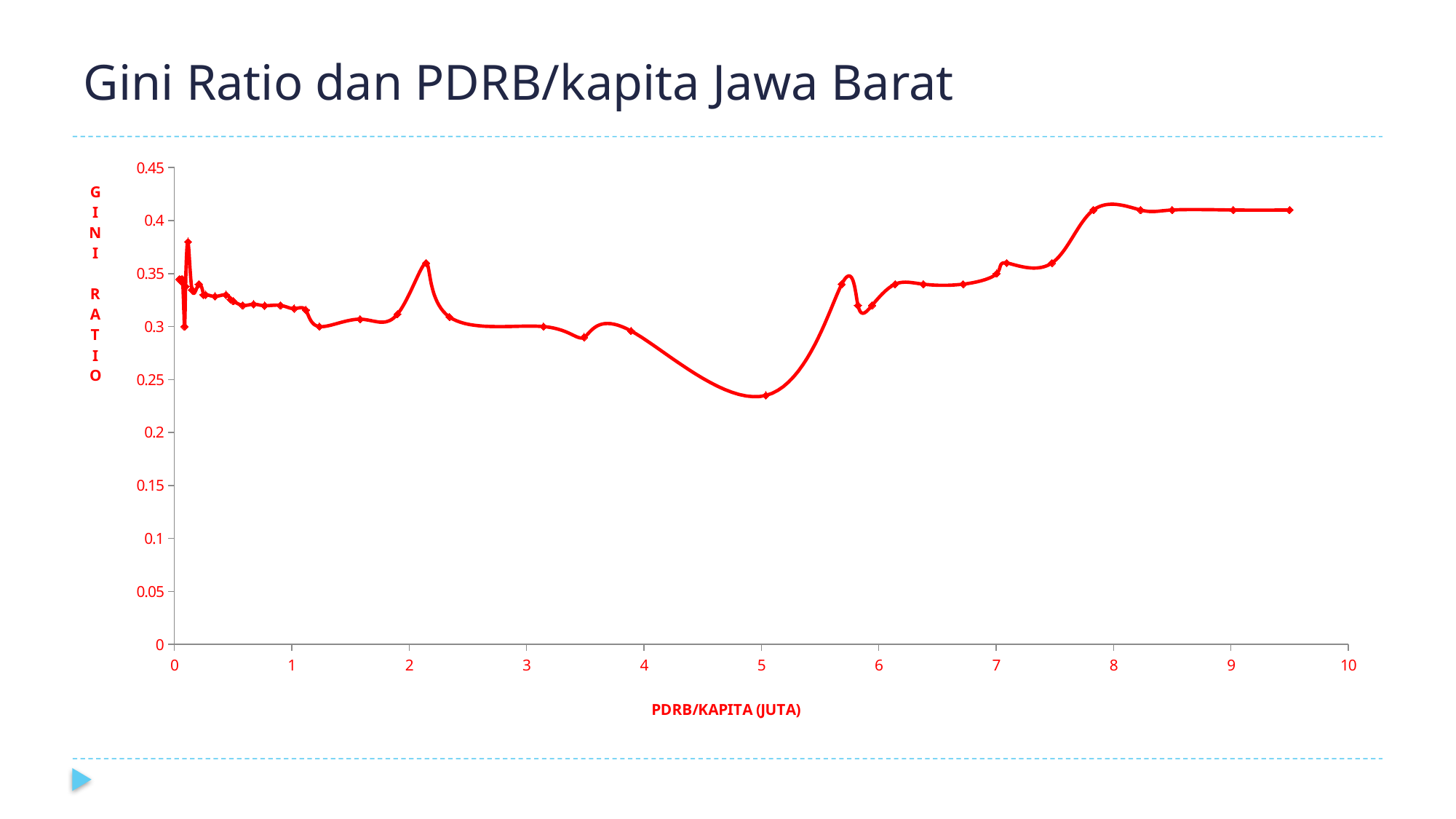
Is the lowest Gini ratio value on the chart (near PDRB/kapita 5) greater or less than 0.25? less What is the highest value shown on the vertical axis? 0.45 Between PDRB/kapita of 5 and 8, does the Gini ratio rise or fall? rise What kind of chart is shown on the slide? line chart What is the title of the chart on the slide? Gini Ratio dan PDRB/kapita Jawa Barat Is the Gini ratio at the peak near PDRB/kapita 2 greater or less than 0.35? greater Between PDRB/kapita of 2 and 5, does the Gini ratio rise or fall overall? fall The lowest point of the line is closest to which tick on the horizontal axis? 5 Is the Gini ratio at the point near PDRB/kapita 3.5 greater or less than 0.3? less How many data series are plotted on the chart? 1 What is the label of the horizontal axis? PDRB/KAPITA (JUTA)